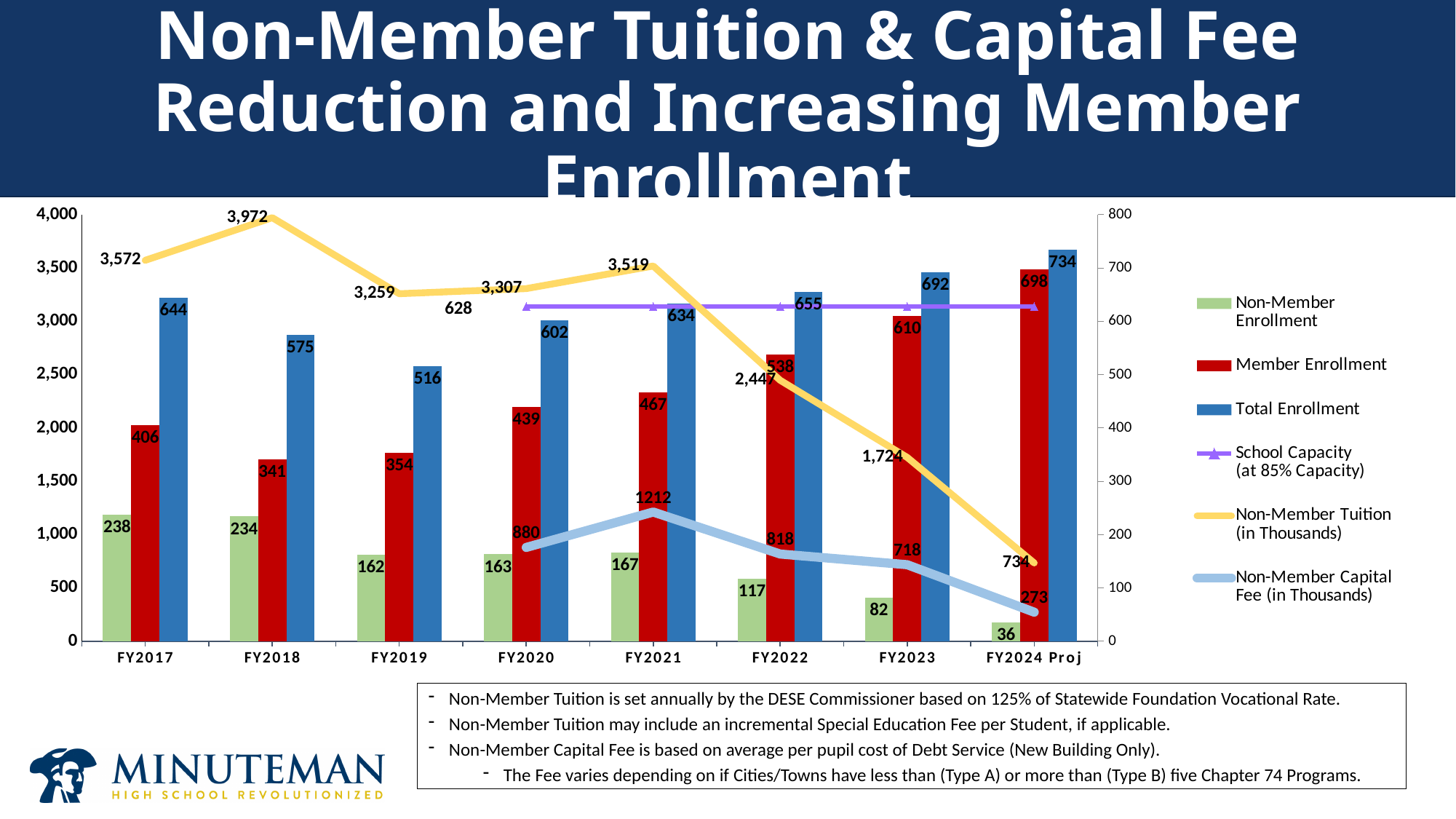
What is the difference between Member Enrollment in FY2024 Proj and FY2017? 292 What is the Member Enrollment value for FY2021? 467 What is the Non-Member Capital Fee (in Thousands) value for FY2021? 1212 How many fiscal years are shown on the x axis? 8 Which fiscal year has the lowest Non-Member Enrollment? FY2024 Proj Does Non-Member Enrollment rise or fall from FY2021 to FY2024 Proj? Fall Which fiscal year has the highest Total Enrollment? FY2024 Proj What kind of chart is used for the enrollment series? Bar chart Which is larger, Non-Member Tuition (in Thousands) in FY2020 or in FY2022? FY2020 What value is shown for School Capacity (at 85% Capacity)? 628 How many series does the legend list? 6 What is the Non-Member Tuition (in Thousands) value for FY2018? 3,972